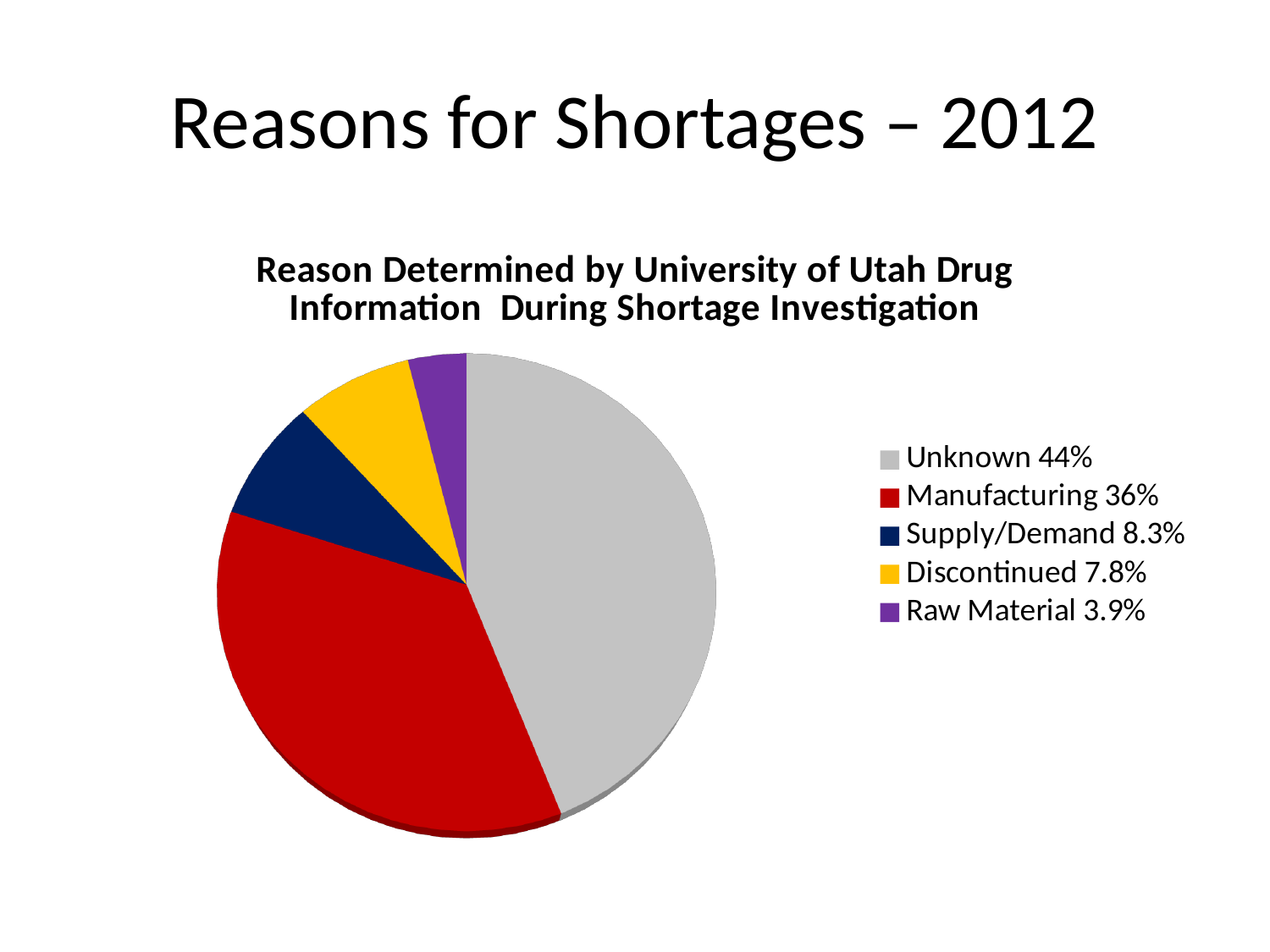
What colour is the Manufacturing slice? Red What is the difference in percentage points between Unknown and Manufacturing? 8 How many categories does the pie chart show? 5 What share of the pie does Supply/Demand account for? 8.3% Which category has the largest slice of the pie? Unknown What share of the pie does Manufacturing account for? 36% What share of the pie does Unknown account for? 44% What kind of chart is shown on the slide? Pie chart Which is larger, the share for Supply/Demand or the share for Discontinued? Supply/Demand Which category has the smallest slice of the pie? Raw Material